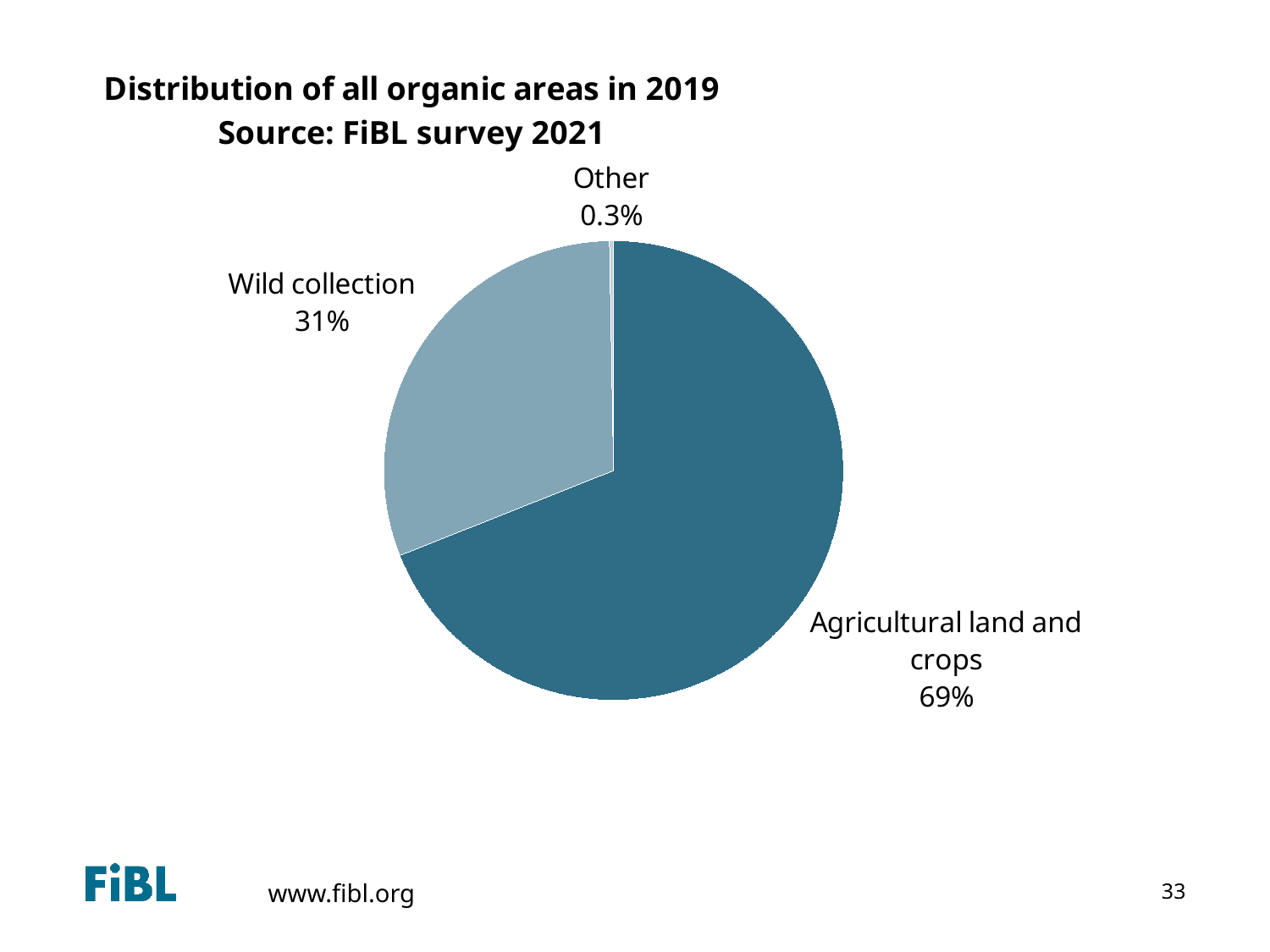
How many categories are shown in the pie chart? 3 What kind of chart is shown on the slide? Pie chart Which category has the smallest share of organic areas in 2019? Other Which is larger: the share of wild collection or the share of Other? Wild collection What share of all organic areas in 2019 is agricultural land and crops? 69% What share of all organic areas in 2019 is wild collection? 31% How many percentage points larger is the share of agricultural land and crops than the share of wild collection? 38 What share of all organic areas in 2019 is labelled Other? 0.3% Which category has the largest share of organic areas in 2019? Agricultural land and crops What source is cited for the chart data? FiBL survey 2021 What is the title of the chart? Distribution of all organic areas in 2019